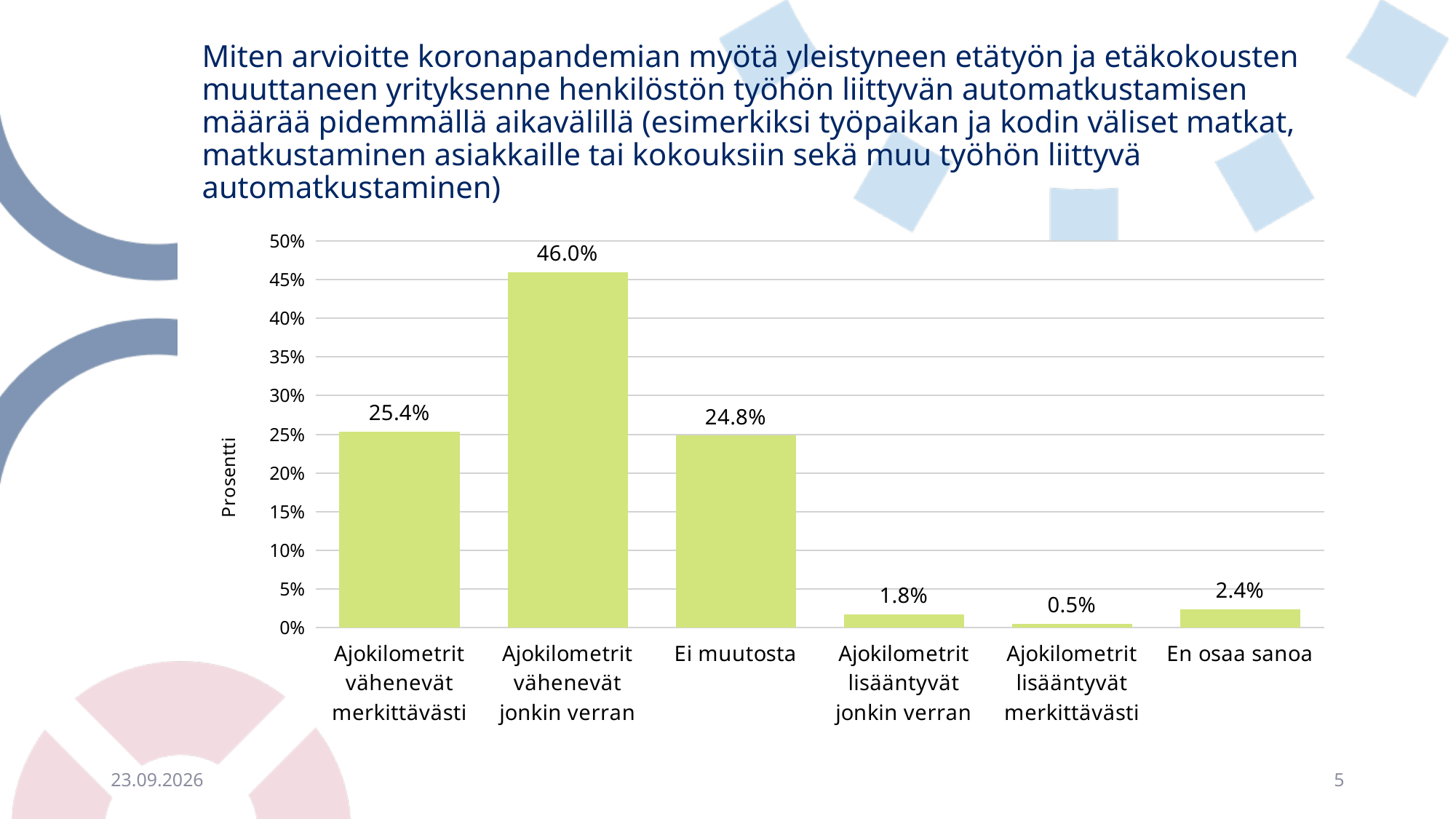
What is the value for "Ajokilometrit lisääntyvät merkittävästi"? 0.5% What is the value for "Ajokilometrit vähenevät jonkin verran"? 46.0% What kind of chart is shown on the slide? bar chart What is the value for "En osaa sanoa"? 2.4% What is the value for "Ei muutosta"? 24.8% What is the label of the vertical axis? Prosentti Which category has the highest value? Ajokilometrit vähenevät jonkin verran Which is larger: "Ajokilometrit vähenevät merkittävästi" or "Ei muutosta"? Ajokilometrit vähenevät merkittävästi What is the difference between "Ajokilometrit vähenevät jonkin verran" and "Ajokilometrit vähenevät merkittävästi"? 20.6% How many categories are shown on the x axis? 6 Is the value for "Ajokilometrit vähenevät jonkin verran" greater or less than 40%? greater Which category has the lowest value? Ajokilometrit lisääntyvät merkittävästi